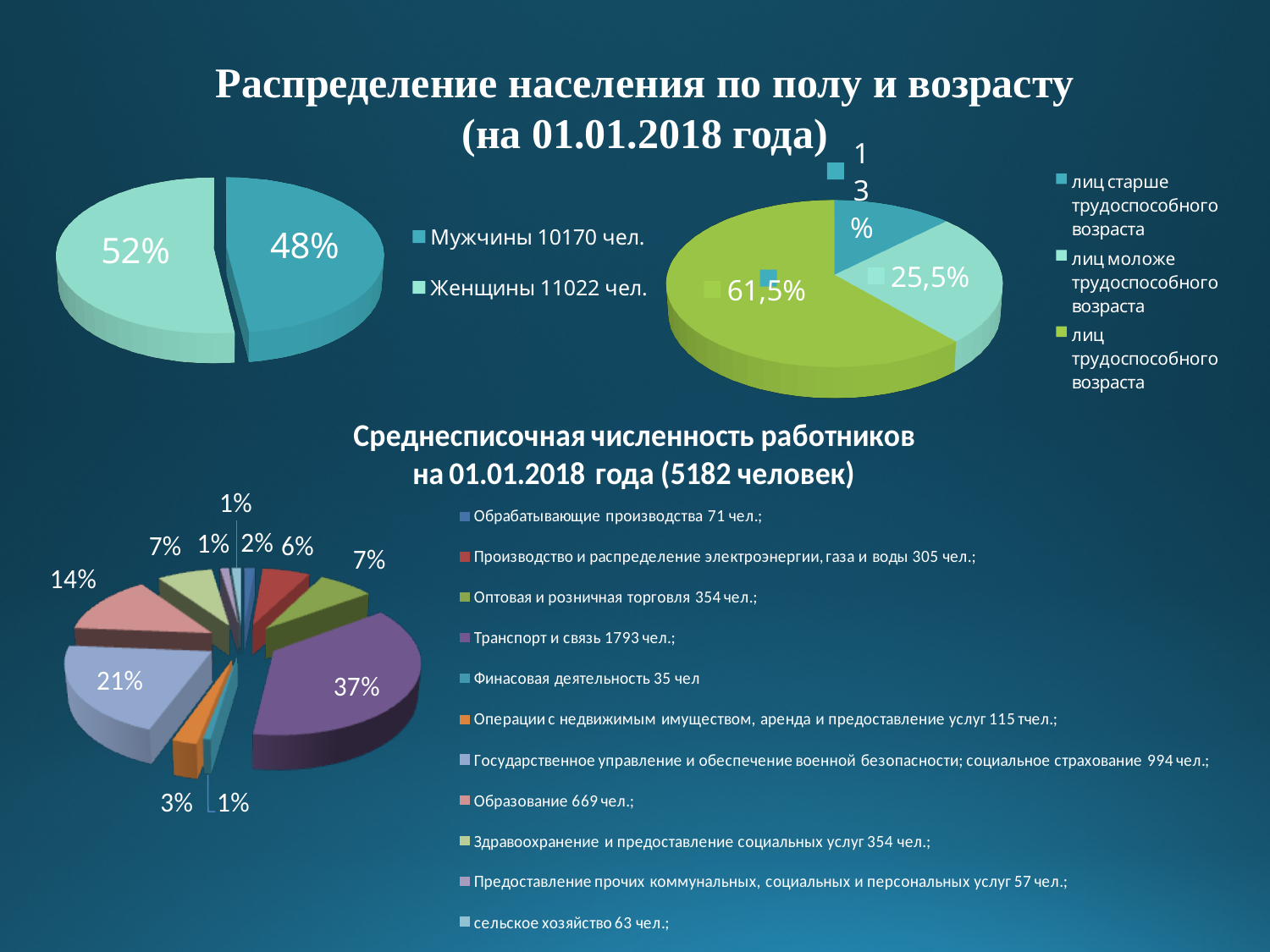
In the top-left pie chart, what share of the population is women (Женщины)? 52% In the top-right pie chart, what share is shown for лиц моложе трудоспособного возраста? 25,5% In the top-right pie chart, what share is shown for лиц трудоспособного возраста? 61,5% In the bottom pie chart, what is the difference between the 37% slice and the 21% slice? 16% In the top-right pie chart, which category has the smallest slice? лиц старше трудоспособного возраста In the top-left pie chart, which group is larger, Мужчины or Женщины? Женщины How many entries does the legend of the bottom pie chart (Среднесписочная численность работников) list? 11 In the top-left pie chart, what number of men (Мужчины) does the legend give? 10170 чел. How many entries does the legend of the top-right pie chart list? 3 In the bottom chart's legend, how many workers are listed for Транспорт и связь? 1793 чел. What kind of chart is the top-left chart showing 52% and 48%? Pie chart In the bottom pie chart (Среднесписочная численность работников), what is the share of the largest slice? 37%